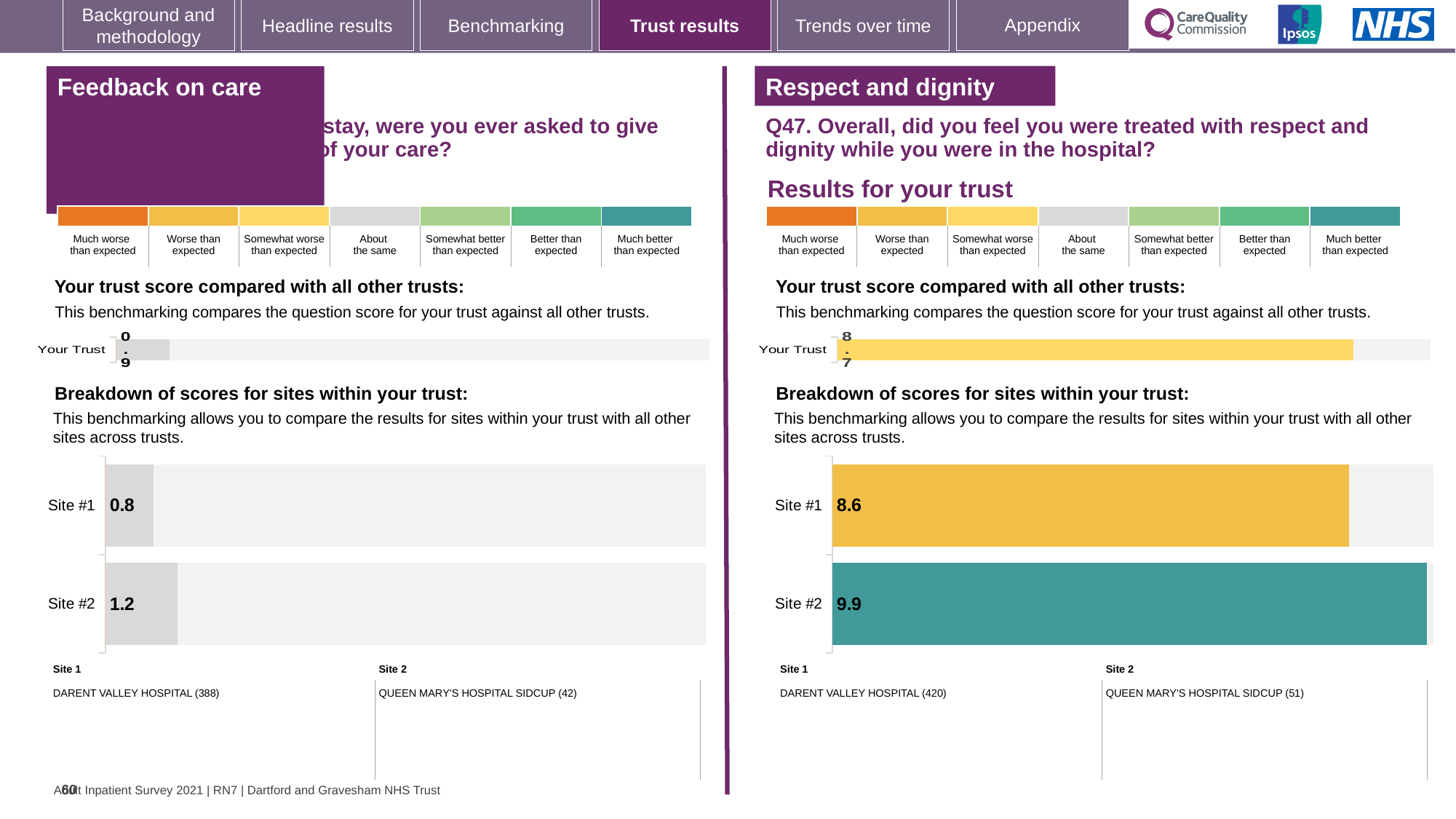
In the 'Feedback on care' section on the left, what is the score for Site #2 in the breakdown of scores for sites chart? 1.2 In the 'Feedback on care' breakdown of scores for sites chart, which site has the lower score? Site #1 In the 'Respect and dignity' breakdown of scores for sites chart, what is the difference between the Site #2 and Site #1 scores? 1.3 In the 'Respect and dignity' section on the right, what is the score for Site #1 in the breakdown of scores for sites chart? 8.6 How many sites are shown in the 'Respect and dignity' breakdown of scores for sites chart? 2 In the 'Feedback on care' breakdown of scores for sites chart, what is the difference between the Site #2 and Site #1 scores? 0.4 In the 'Respect and dignity' breakdown of scores for sites chart, which site has the higher score? Site #2 What type of chart is used for the breakdown of scores for sites in the 'Respect and dignity' section? Bar chart In the 'Respect and dignity' section on the right, what is the 'Your Trust' score shown in the trust comparison chart? 8.7 In the 'Feedback on care' section on the left, what is the score for Site #1 in the breakdown of scores for sites chart? 0.8 In the 'Feedback on care' section on the left, what is the 'Your Trust' score shown in the trust comparison chart? 0.9 In the 'Respect and dignity' section on the right, what is the score for Site #2 in the breakdown of scores for sites chart? 9.9